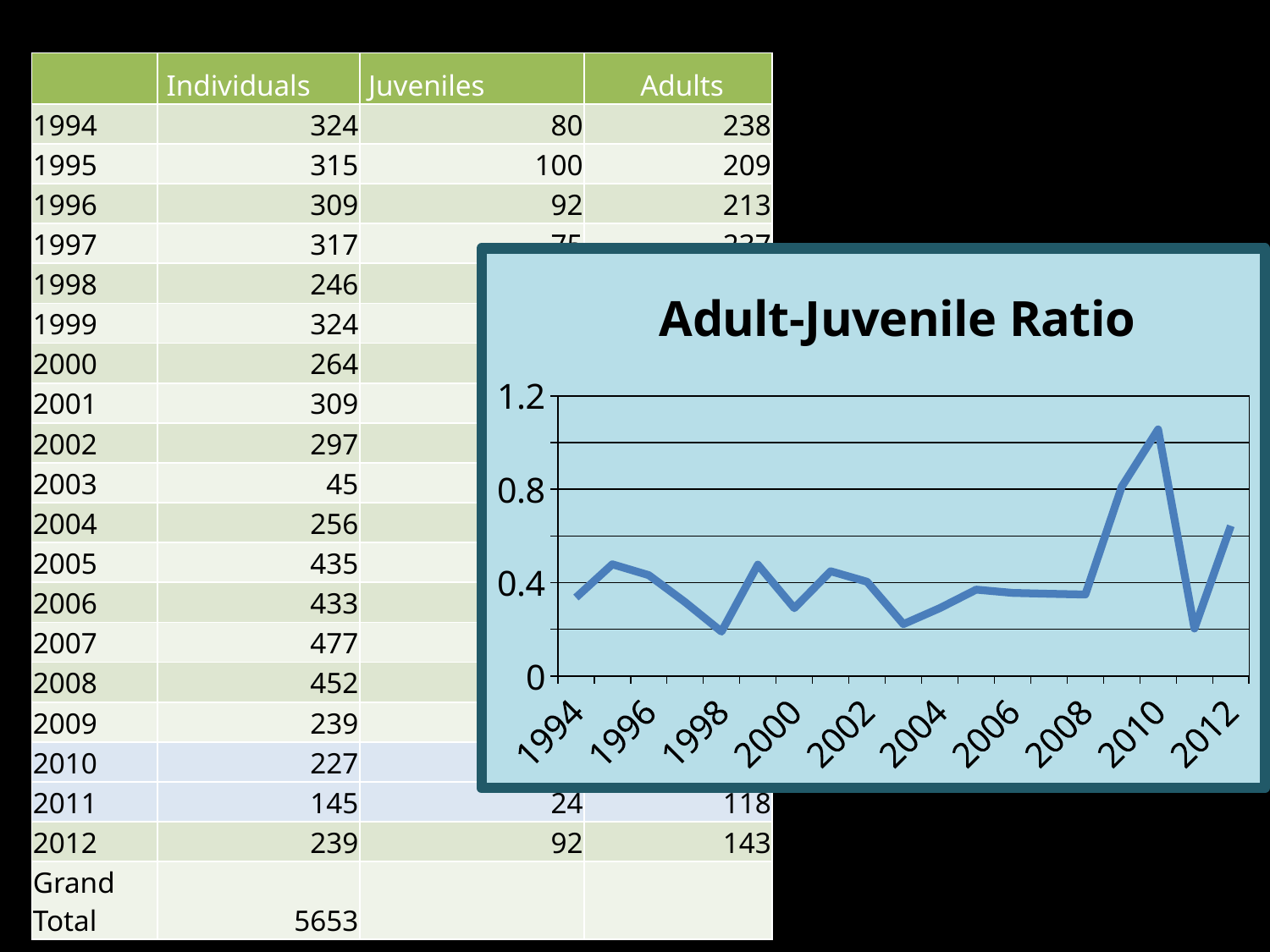
Is the Adult-Juvenile Ratio for 2010 greater or less than 0.8? greater What is the title of the chart on the slide? Adult-Juvenile Ratio What is the highest value shown on the y axis of the Adult-Juvenile Ratio chart? 1.2 Does the Adult-Juvenile Ratio rise or fall from 2010 to 2011? fall Which year has the larger Adult-Juvenile Ratio, 2009 or 2008? 2009 What kind of chart is the Adult-Juvenile Ratio chart? line chart Which year has the larger Adult-Juvenile Ratio, 2010 or 2011? 2010 Is the Adult-Juvenile Ratio for 2012 greater or less than 0.4? greater Is the Adult-Juvenile Ratio for 2011 greater or less than 0.4? less In which year does the Adult-Juvenile Ratio reach its highest value? 2010